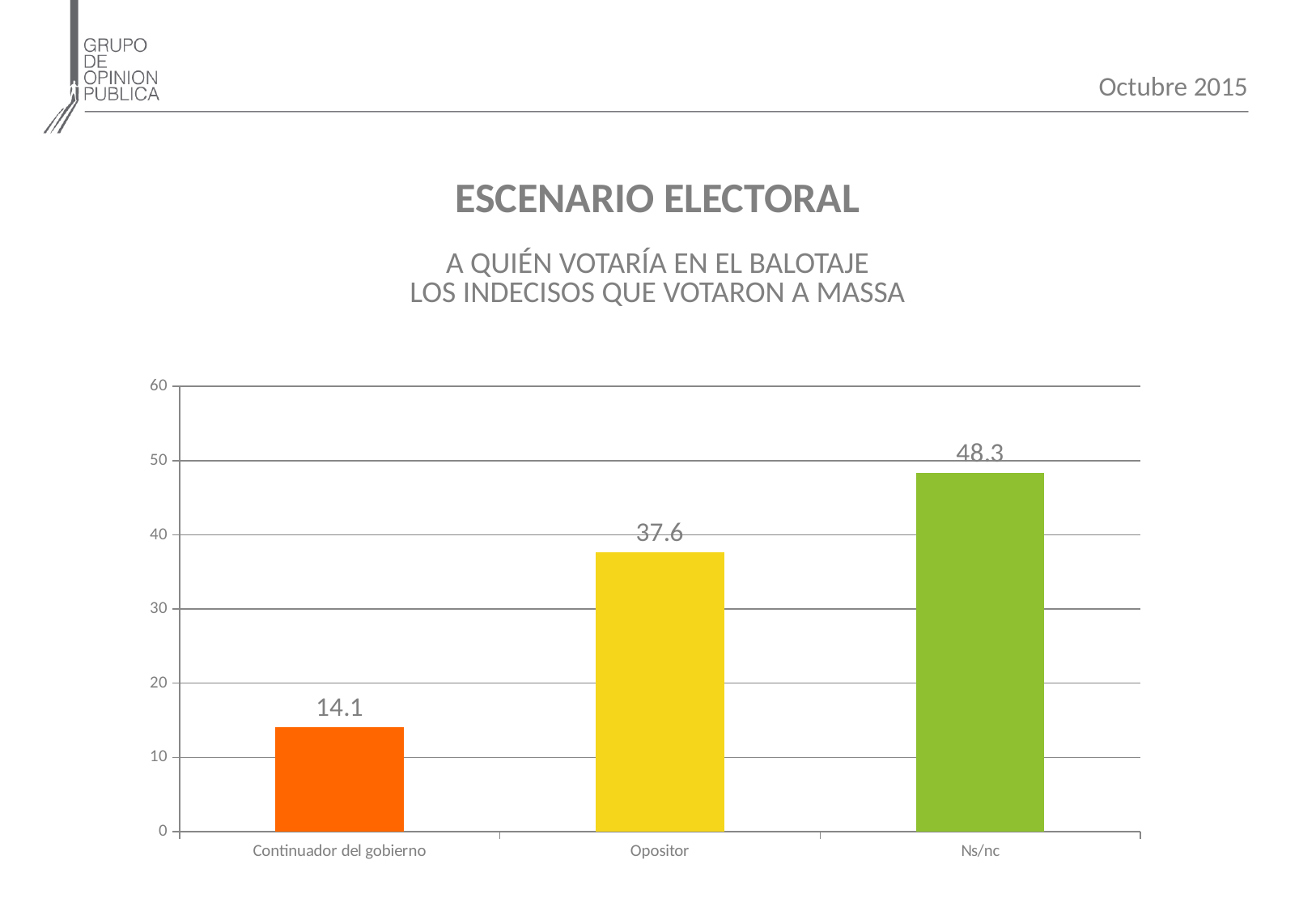
What is the difference between the values for Opositor and Continuador del gobierno? 23.5 What kind of chart is shown on the slide? bar chart What is the value for Continuador del gobierno? 14.1 Which category has the highest value? Ns/nc How many categories are shown on the x axis? 3 What is the value for Ns/nc? 48.3 Which category has the lowest value? Continuador del gobierno What is the value for Opositor? 37.6 Which is larger, the value for Opositor or the value for Continuador del gobierno? Opositor Is the value for Ns/nc greater or less than 40? greater What is the difference between the values for Ns/nc and Opositor? 10.7 What colour is the bar for Ns/nc? green